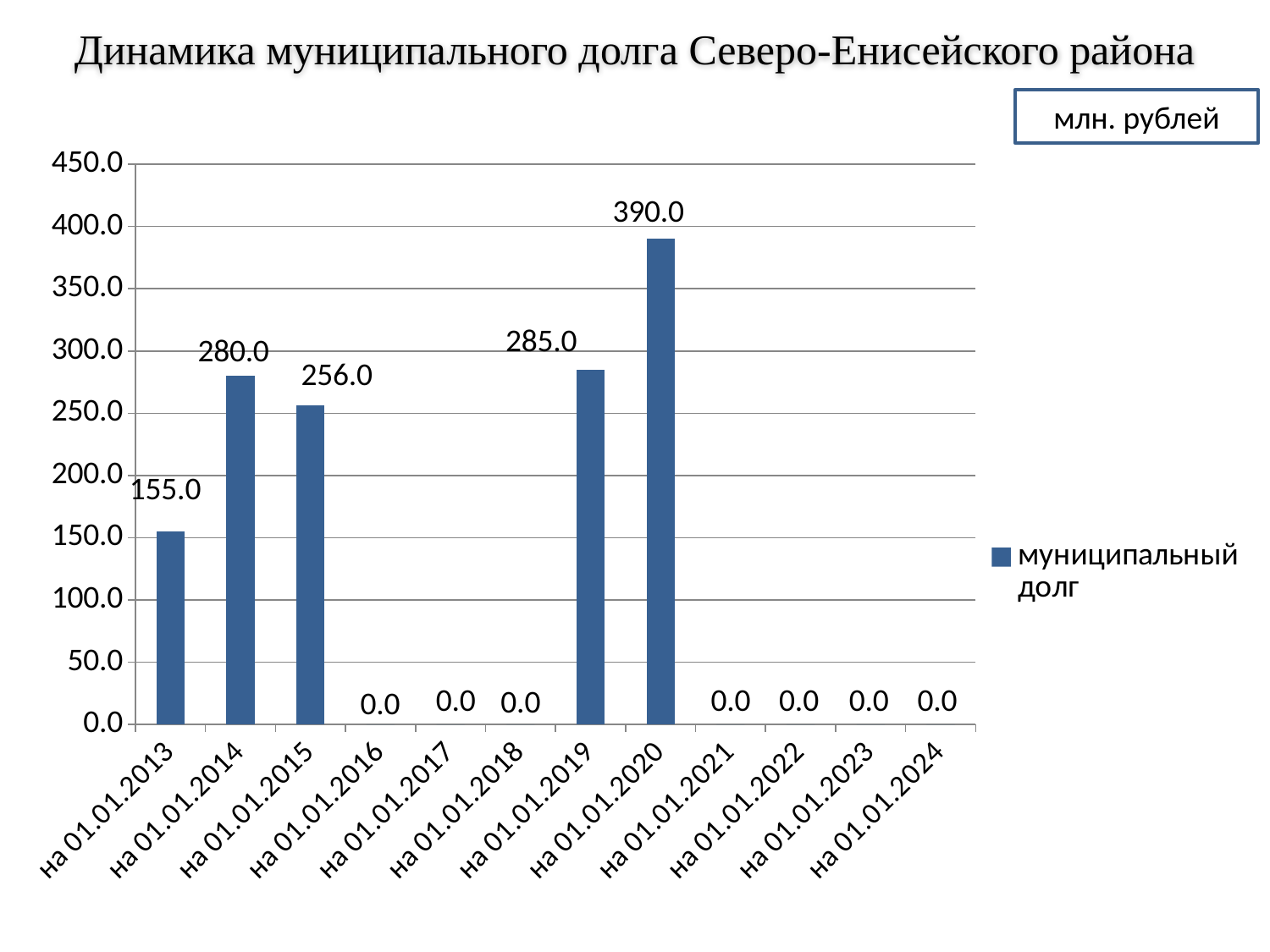
How many dates (categories) are shown on the x axis? 12 How many series does the legend list? 1 What kind of chart is shown on the slide? bar chart Is the municipal debt on 01.01.2019 greater or less than 250.0? greater Which is larger: the municipal debt on 01.01.2014 or on 01.01.2015? на 01.01.2014 Which date has the highest municipal debt? на 01.01.2020 What is the difference between the municipal debt on 01.01.2014 and on 01.01.2013? 125.0 What unit of measurement is indicated in the box at the top right of the slide? млн. рублей What is the value of municipal debt on 01.01.2015? 256.0 What is the value of municipal debt on 01.01.2020? 390.0 What is the value of municipal debt (муниципальный долг) on 01.01.2013? 155.0 What is the difference between the municipal debt on 01.01.2020 and on 01.01.2019? 105.0